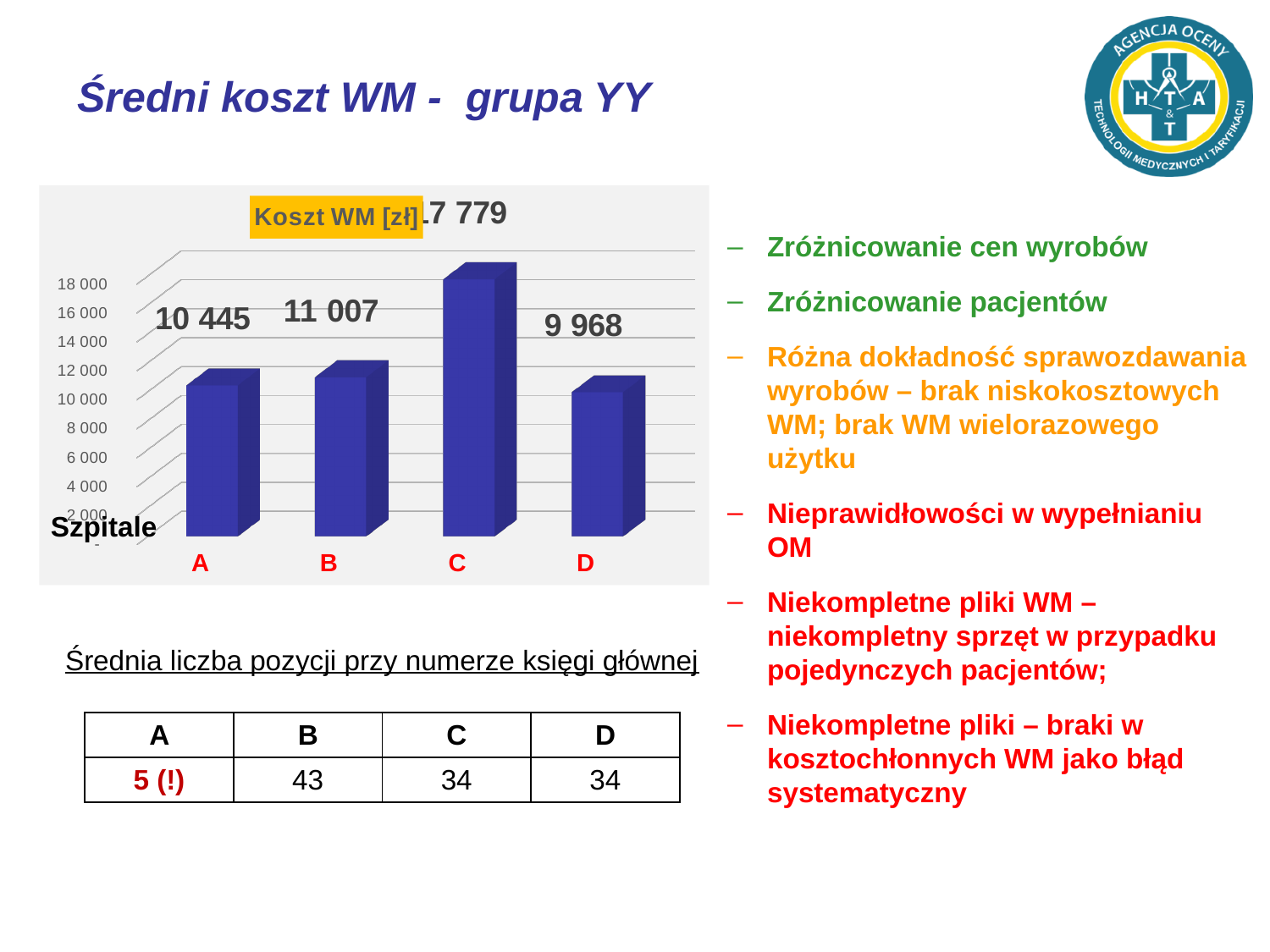
What is the value for hospital B in the Koszt WM [zł] chart? 11 007 What is the difference between the Koszt WM values for hospitals A and D? 477 What is the value for hospital D in the Koszt WM [zł] chart? 9 968 What is the value for hospital A in the Koszt WM [zł] chart? 10 445 Which hospital has a higher Koszt WM, A or B? B Which hospital has the lowest Koszt WM [zł]? D Is the Koszt WM value for hospital C greater or less than 16 000? greater How many hospitals are shown in the Koszt WM [zł] chart? 4 What is the label on the horizontal axis of the Koszt WM [zł] chart? Szpitale What is the difference between the Koszt WM values for hospitals B and A? 562 What type of chart is used to show Koszt WM [zł]? bar chart Which hospital has the highest Koszt WM [zł]? C